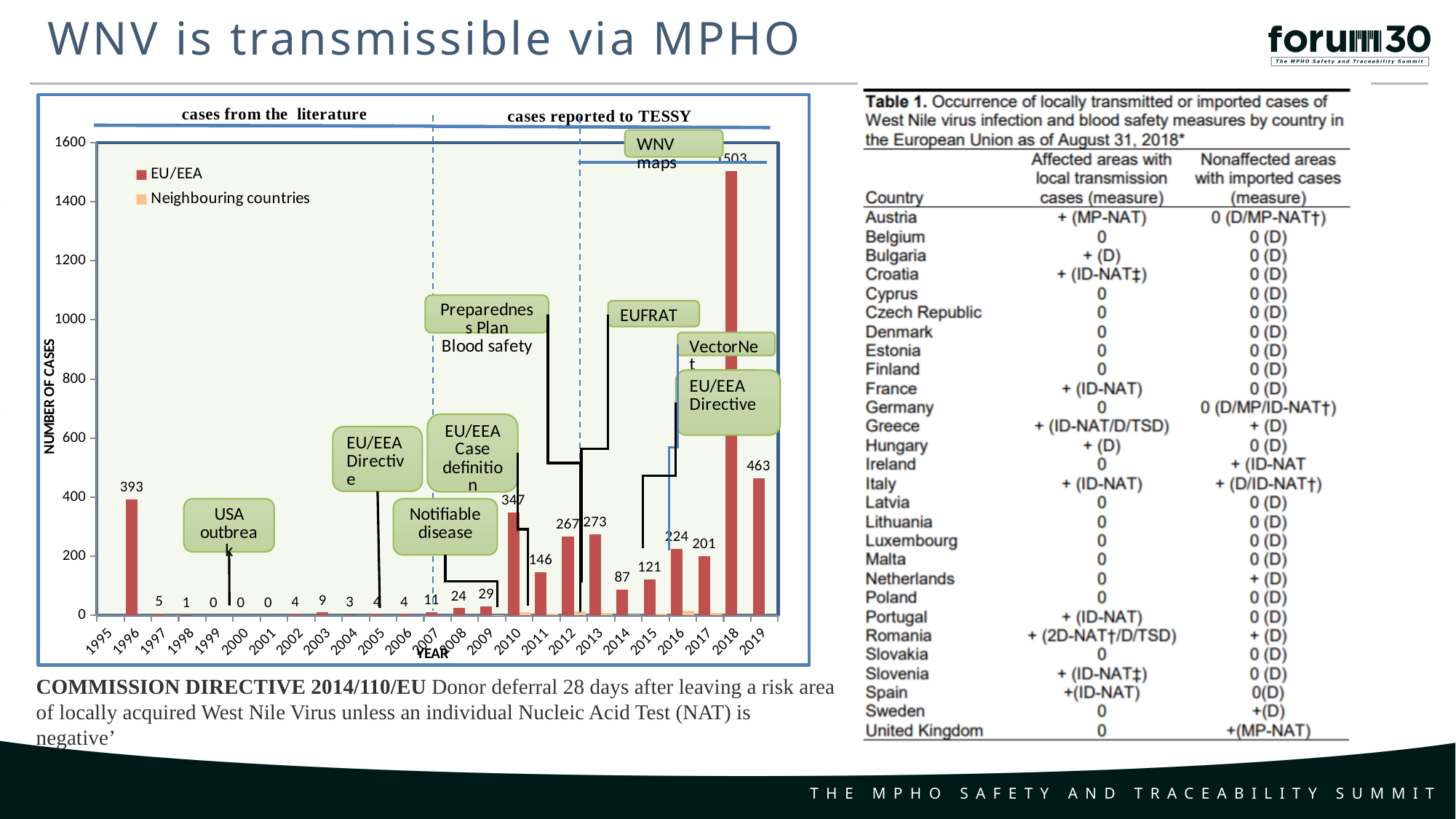
What is the difference between the EU/EEA cases in 2013 and 2012? 6 What is the number of EU/EEA cases shown for 2010? 347 How many years are shown on the x axis of the chart? 25 What is the number of EU/EEA cases shown for 2008? 24 How many series does the chart legend list? 2 What kind of chart is shown on the slide? bar chart Is the value for EU/EEA cases in 2011 greater or less than 200? less Which year has the highest number of EU/EEA cases? 2018 What are the two series named in the chart legend? EU/EEA and Neighbouring countries Which year has more EU/EEA cases, 2016 or 2017? 2016 What is the number of EU/EEA cases shown for 2019? 463 What is the number of EU/EEA cases shown for 2014? 87